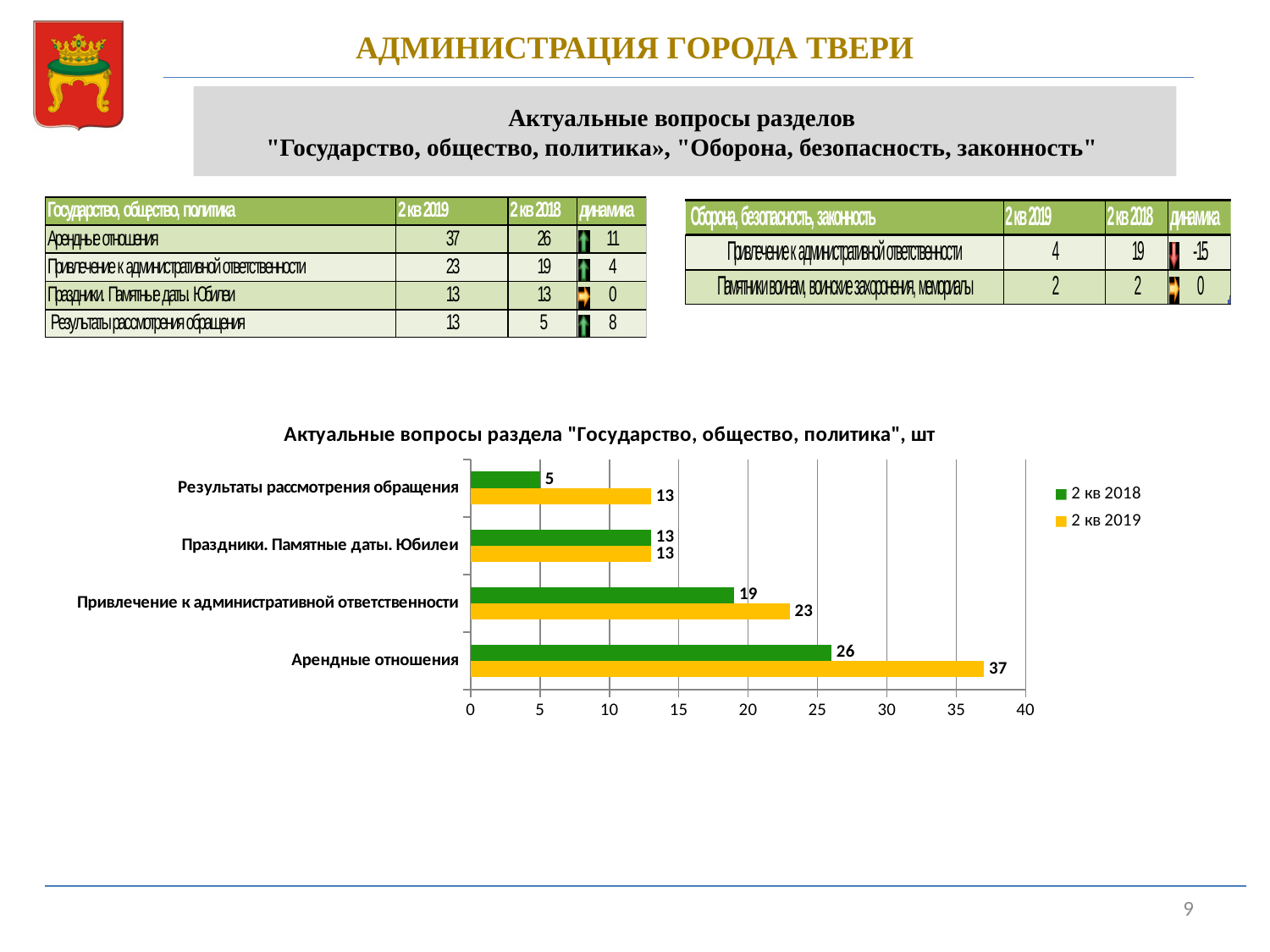
What is the difference between the 2 кв 2019 and 2 кв 2018 values for Арендные отношения? 11 What is the value for Привлечение к административной ответственности in the 2 кв 2019 series? 23 What type of chart is shown on the slide? bar chart How many categories are shown on the chart? 4 What is the value for Результаты рассмотрения обращения in the 2 кв 2018 series? 5 What is the value for Арендные отношения in the 2 кв 2018 series? 26 Which is larger for Привлечение к административной ответственности: the 2 кв 2018 value or the 2 кв 2019 value? 2 кв 2019 Which category has the lowest value in the 2 кв 2018 series? Результаты рассмотрения обращения What is the value for Арендные отношения in the 2 кв 2019 series? 37 What is the title of the chart? Актуальные вопросы раздела "Государство, общество, политика", шт Which category has the highest value in the 2 кв 2019 series? Арендные отношения How many series does the chart legend list? 2